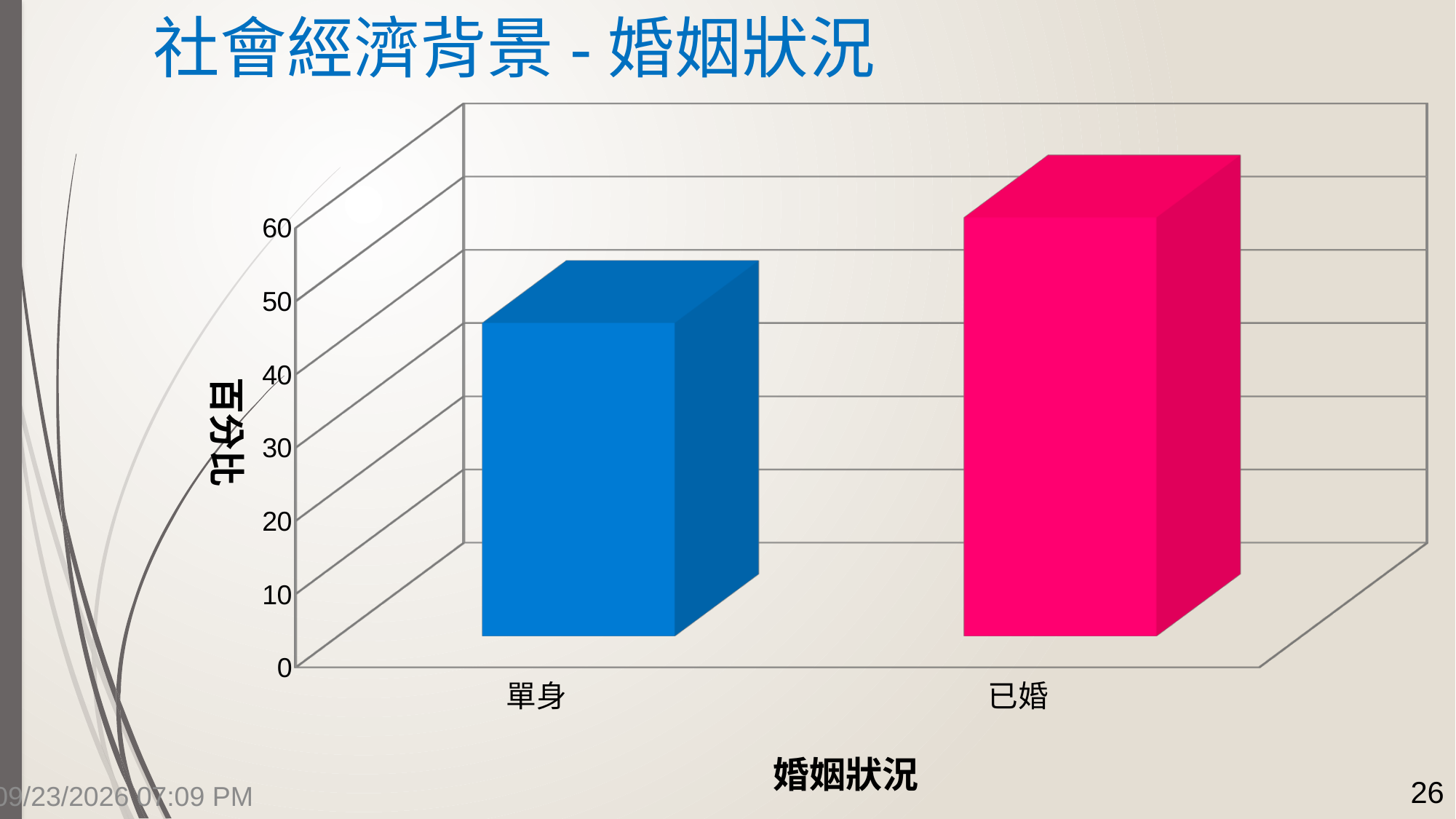
Is the value for 已婚 greater or less than 40? greater Is the value for 單身 greater or less than 60? less Which category has the lowest bar in the chart? 單身 Which category has the highest bar in the chart? 已婚 Is the value for 單身 greater or less than 30? greater How many categories are shown on the x axis of the chart? 2 What is the title of the horizontal axis of the chart? 婚姻狀況 What is the title of the vertical axis of the chart? 百分比 Which is larger, the value for 單身 or the value for 已婚? 已婚 What kind of chart is shown on the slide? bar chart